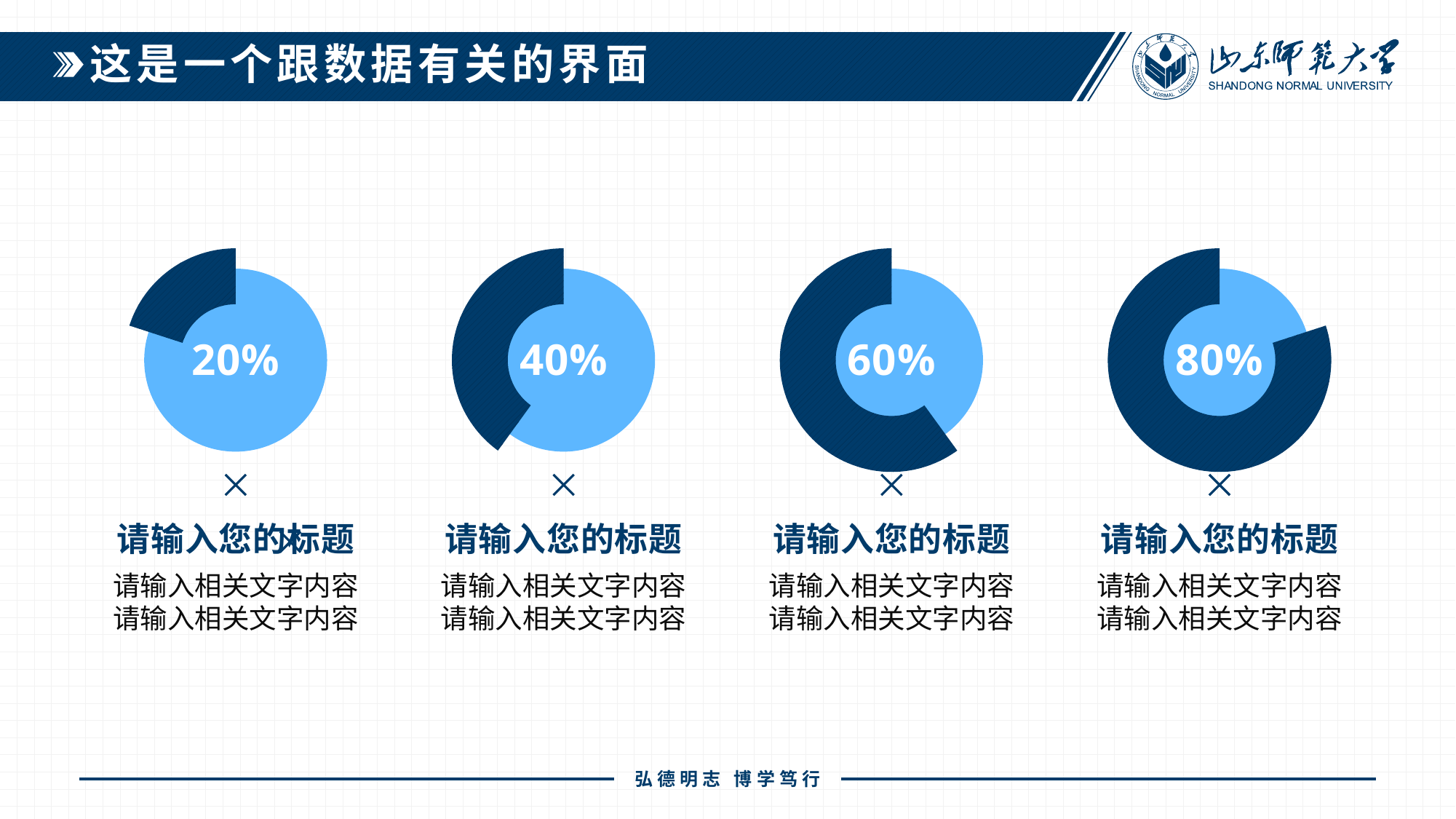
Which is larger, the percentage in the second chart from the left or the percentage in the third chart from the left? The third chart from the left (60%) What colour is the slice representing the stated percentage in each chart? Dark blue What kind of chart is used for each of the four figures on the slide? Doughnut (ring) chart Do the percentages rise or fall moving from the leftmost chart to the rightmost chart? Rise What percentage is shown in the rightmost chart? 80% What percentage is shown in the second chart from the left? 40% What percentage is shown in the third chart from the left? 60% Which of the four charts shows the lowest percentage? The leftmost chart (20%) What percentage is shown in the leftmost chart? 20% What is the difference between the percentage in the rightmost chart and the percentage in the leftmost chart? 60% How many charts are shown on the slide? 4 Which of the four charts shows the highest percentage? The rightmost chart (80%)